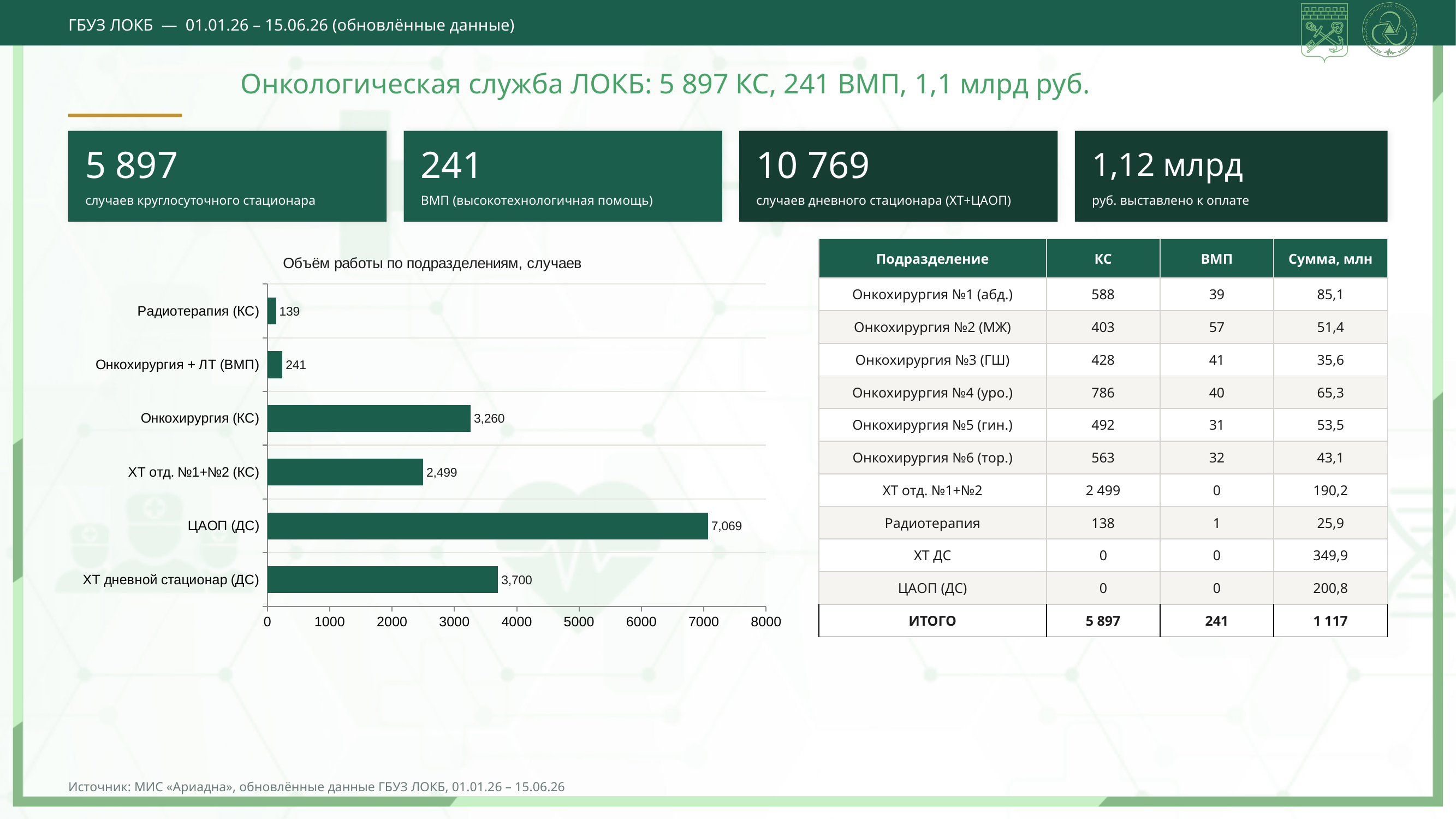
What is the title of the chart? Объём работы по подразделениям, случаев What kind of chart is shown on the slide? bar chart What is the value for Онкохирургия (КС) in the chart? 3,260 What is the value for ХТ дневной стационар (ДС) in the chart? 3,700 Which is larger: the value for Онкохирургия (КС) or the value for ХТ дневной стационар (ДС)? ХТ дневной стационар (ДС) What is the value for ЦАОП (ДС) in the chart? 7,069 How many categories are shown in the chart? 6 Which category has the highest value in the chart? ЦАОП (ДС) What is the value for Радиотерапия (КС) in the chart? 139 What is the difference between the values for ХТ дневной стационар (ДС) and ХТ отд. №1+№2 (КС)? 1,201 Is the value for ХТ отд. №1+№2 (КС) greater or less than 3000? less Which category has the lowest value in the chart? Радиотерапия (КС)